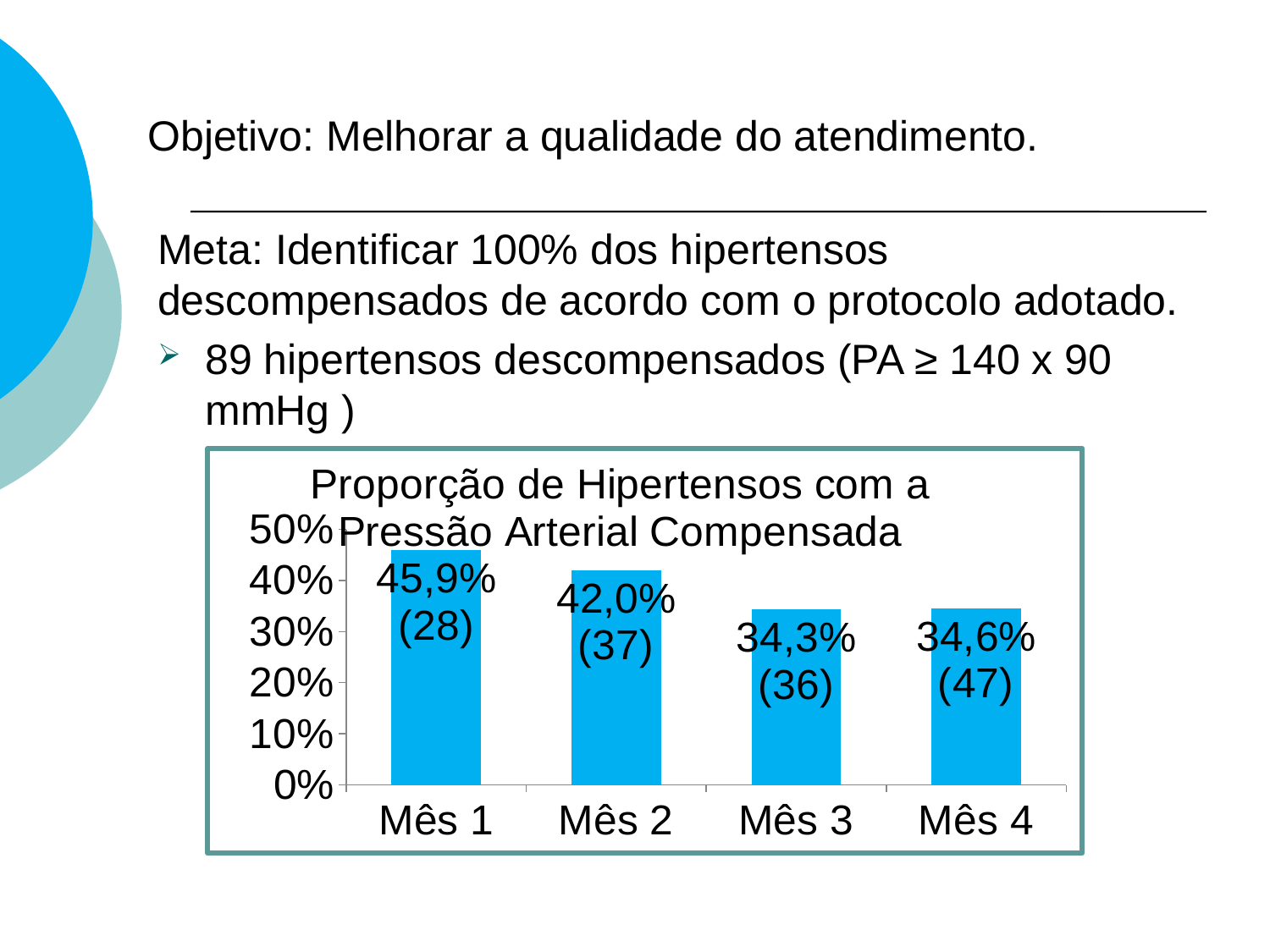
What is the title of the chart? Proporção de Hipertensos com a Pressão Arterial Compensada What number is shown in parentheses for Mês 4? 47 Which month has the highest percentage? Mês 1 Do the percentages rise or fall from Mês 1 to Mês 3? fall How many months (categories) are shown on the x axis of the chart? 4 What number is shown in parentheses for Mês 2? 37 Which has the larger percentage, Mês 3 or Mês 4? Mês 4 What is the difference in percentage points between Mês 1 and Mês 2? 3,9 What is the percentage value for Mês 1? 45,9% What type of chart is shown on the slide? bar chart What is the percentage value for Mês 3? 34,3% Which month has the lowest percentage? Mês 3